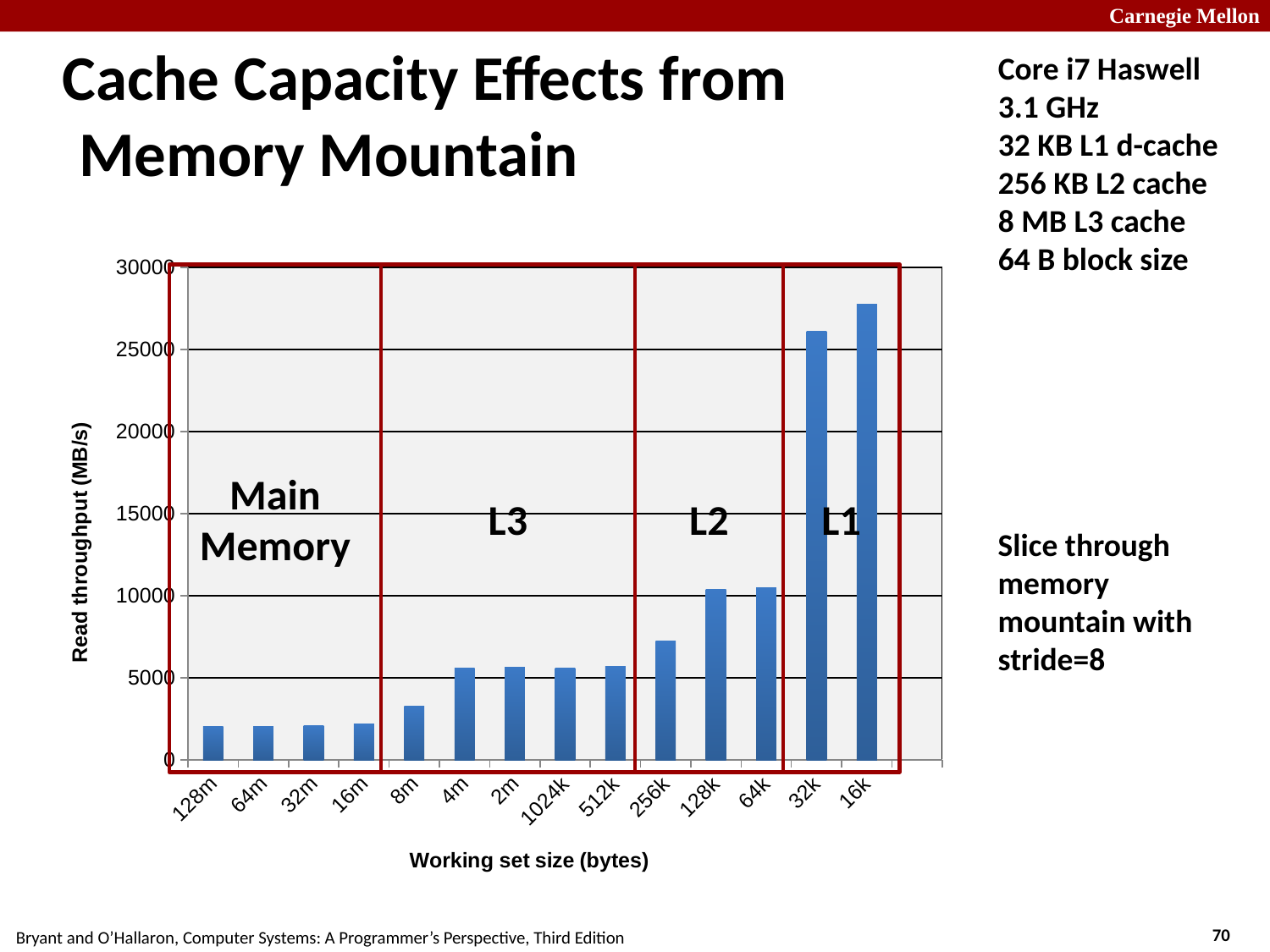
Which has the higher read throughput, a working set size of 32k or 256k? 32k Is the read throughput for a working set size of 16m greater or less than 5000 MB/s? less Which has the higher read throughput, a working set size of 8m or 4m? 4m Is the read throughput for a working set size of 8m greater or less than 5000 MB/s? less Which working set size has the highest read throughput? 16k Do the read throughput values generally rise or fall moving from left (128m) to right (16k) along the x axis? rise How many working set sizes are plotted along the x axis? 14 What is the label of the y axis? Read throughput (MB/s) Is the read throughput for a working set size of 16k greater or less than 30000 MB/s? less What kind of chart is shown on the slide? bar chart